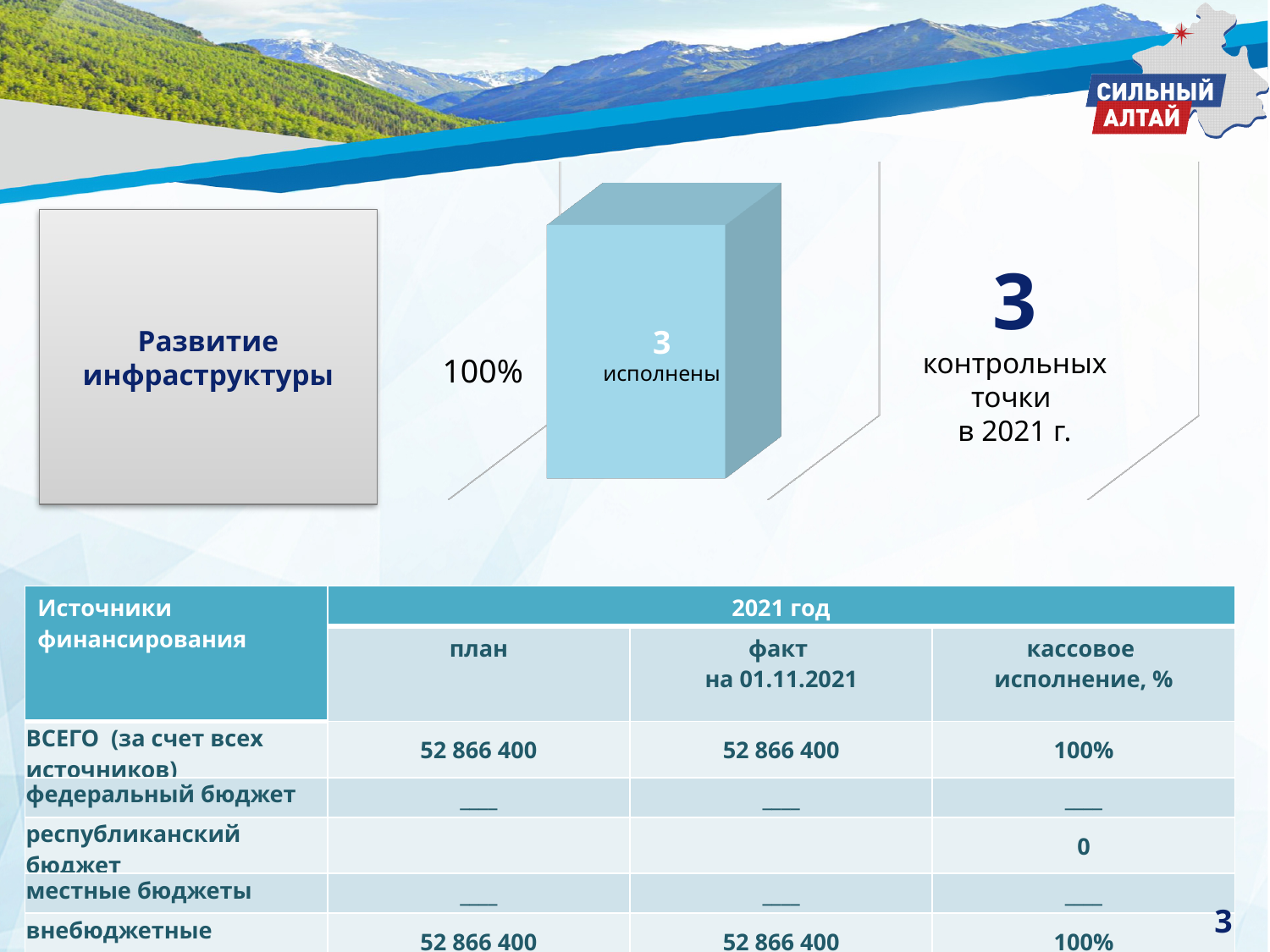
What percentage is printed to the left of the bar? 100% What label accompanies the value on the bar? исполнены How many bars does the chart show? 1 What kind of chart is shown in the middle of the slide? bar chart According to the text to the right of the chart, how many контрольных точек were there in 2021? 3 What colour is the bar in the chart? light blue What value is printed on the bar in the chart? 3